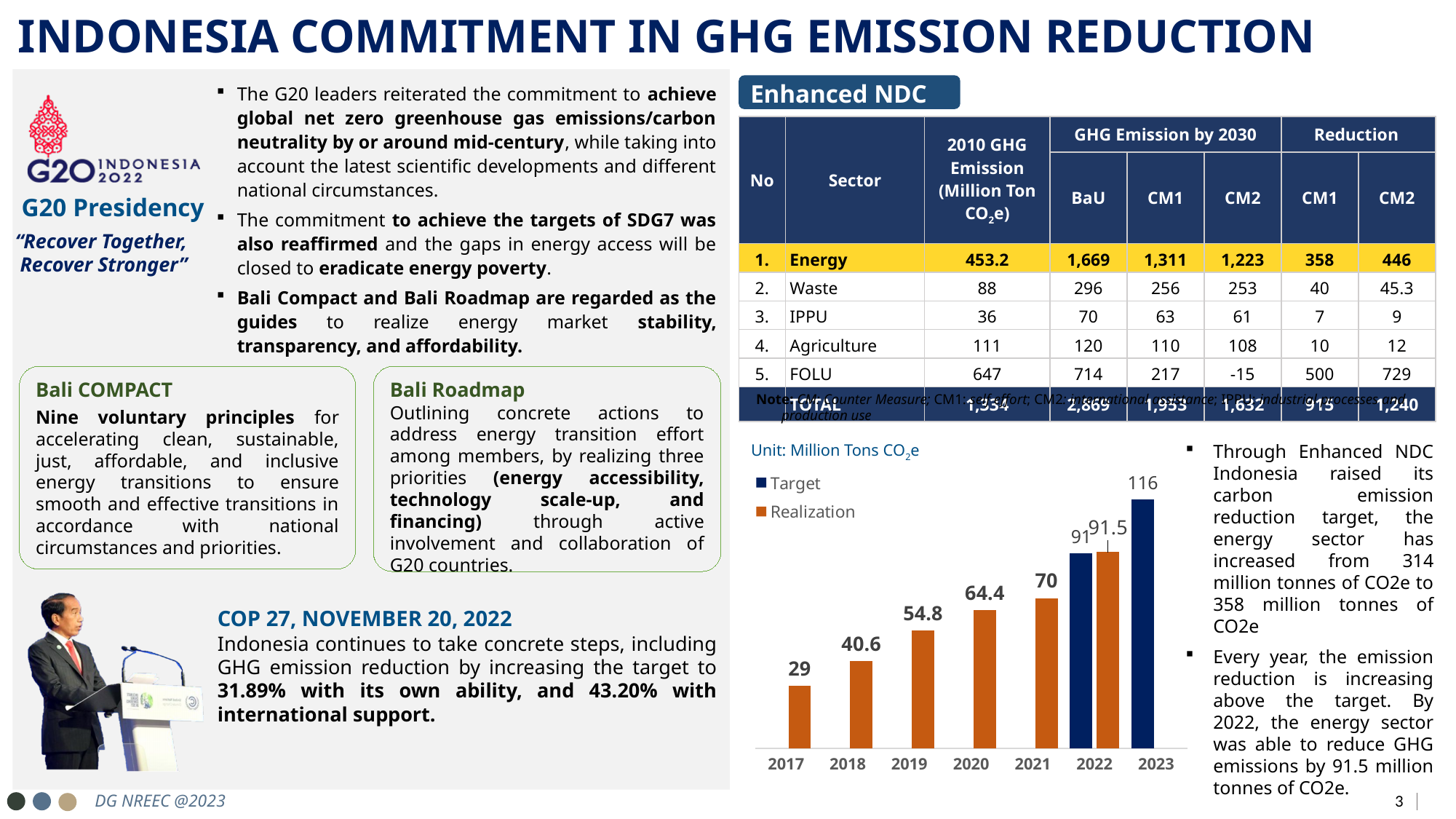
In 2022, which is larger in the bar chart: the Target or the Realization value? Realization What are the two series named in the bar chart legend? Target and Realization What is the Target value for 2022 in the bar chart? 91 Which year has the lowest Realization value in the bar chart? 2017 What is the difference between the Realization values for 2021 and 2020 in the bar chart? 5.6 How many series does the legend of the bar chart list? 2 What is the Realization value for 2019 in the bar chart? 54.8 What is the Target value for 2023 in the bar chart? 116 What is the Realization value for 2017 in the bar chart? 29 Do the Realization values rise or fall from 2017 to 2022 in the bar chart? rise What type of chart is shown at the bottom right of the slide? bar chart How many years are shown on the x axis of the bar chart? 7